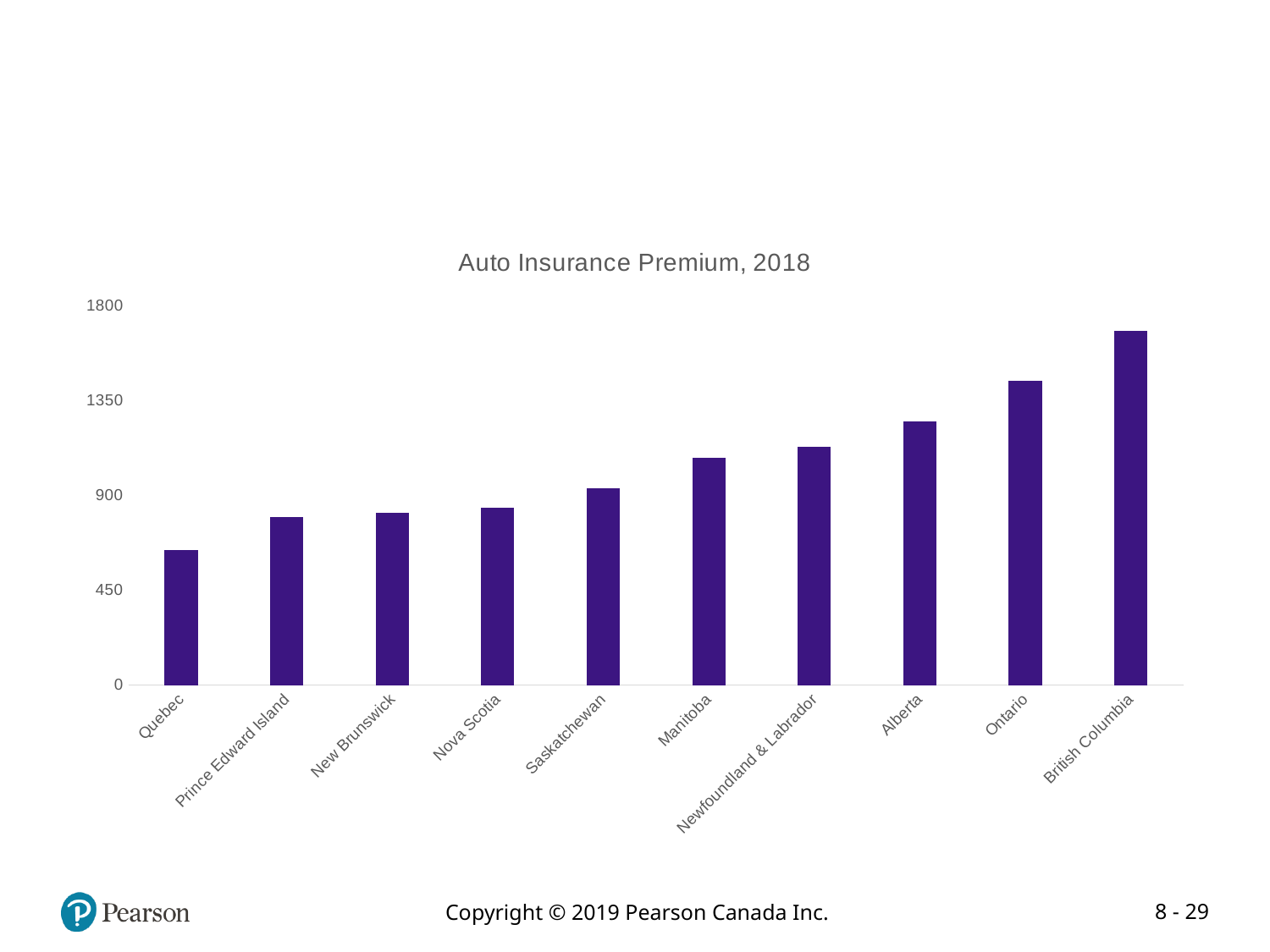
Is the value for Alberta greater or less than 1350? less Is the value for Manitoba greater or less than 900? greater Is the value for Quebec greater or less than 900? less What is the title of the chart? Auto Insurance Premium, 2018 Which has the larger auto insurance premium, Ontario or Alberta? Ontario What kind of chart is shown on the slide? bar chart Which province has the highest auto insurance premium in the chart? British Columbia Do the values rise or fall moving from left to right along the x axis? rise How many provinces are shown on the x axis of the chart? 10 Which province has the lowest auto insurance premium in the chart? Quebec